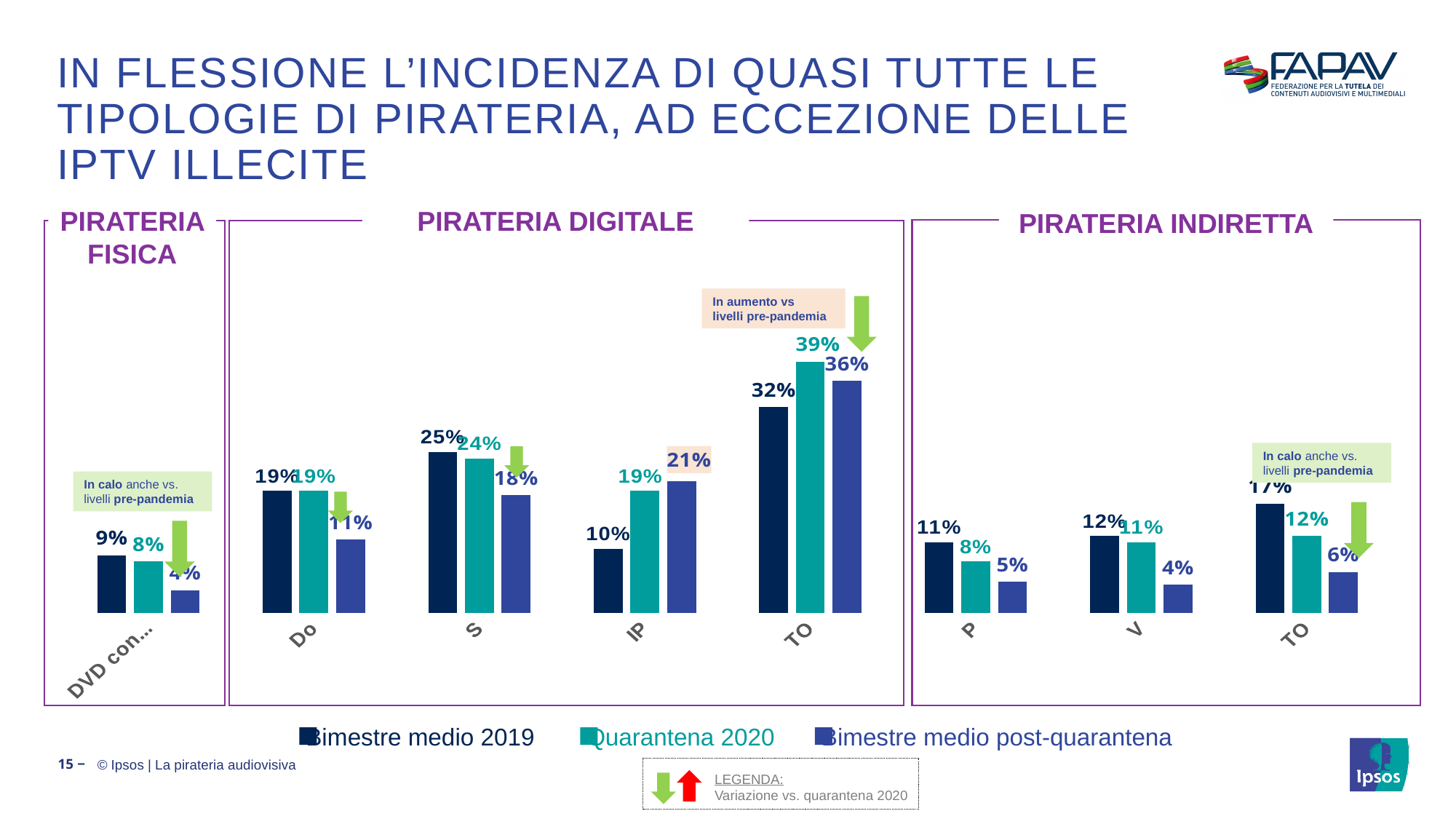
How many categories are plotted in the Pirateria Digitale section? 4 What kind of chart is shown on the slide? bar chart For the S category in the Pirateria Digitale section, which is larger: the Bimestre medio 2019 value or the Bimestre medio post-quarantena value? Bimestre medio 2019 What is the Bimestre medio 2019 value for the IP category in the Pirateria Digitale section? 10% What is the Bimestre medio post-quarantena value for the DVD category in the Pirateria Fisica section? 4% Which category has the highest Quarantena 2020 value across the whole chart? TO (Pirateria Digitale) What is the difference between the Quarantena 2020 and Bimestre medio 2019 values for the IP category in the Pirateria Digitale section? 9% What is the difference between the Bimestre medio 2019 and Bimestre medio post-quarantena values for the TO category in the Pirateria Indiretta section? 11% What is the Quarantena 2020 value for the TO category in the Pirateria Digitale section? 39% What is the Bimestre medio post-quarantena value for the V category in the Pirateria Indiretta section? 4% Which series is shown in dark navy bars? Bimestre medio 2019 How many series does the legend list? 3